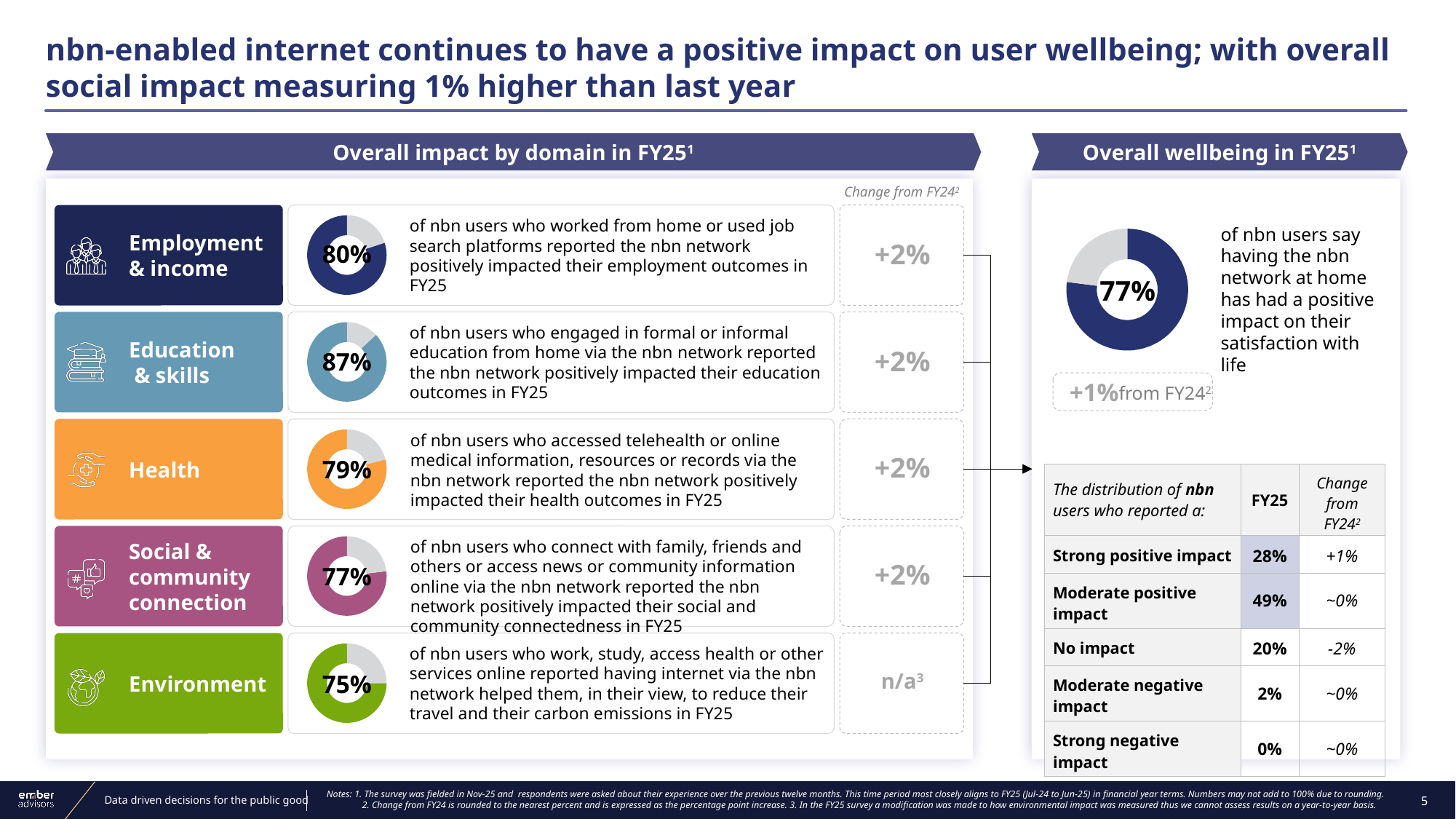
In the 'Overall wellbeing in FY25' panel, what percentage is shown in the donut chart? 77% Among the five domain donut charts in the 'Overall impact by domain in FY25' panel, which domain has the lowest percentage? Environment In the 'Overall impact by domain in FY25' panel, what percentage is shown in the Environment donut chart? 75% In the 'Overall impact by domain in FY25' panel, what percentage is shown in the Employment & income donut chart? 80% In the 'Overall impact by domain in FY25' panel, what change from FY24 is shown next to the Health donut chart? +2% In the 'Overall impact by domain in FY25' panel, which donut chart shows a larger value: Employment & income or Health? Employment & income In the 'Overall impact by domain in FY25' panel, what percentage is shown in the Education & skills donut chart? 87% What type of chart is used to show the Social & community connection value in the 'Overall impact by domain in FY25' panel? Donut (pie) chart In the 'Overall impact by domain in FY25' panel, what percentage is shown in the Health donut chart? 79% Among the five domain donut charts in the 'Overall impact by domain in FY25' panel, which domain has the highest percentage? Education & skills How many domain donut charts are shown in the 'Overall impact by domain in FY25' panel? 5 In the 'Overall impact by domain in FY25' panel, what is the difference in percentage points between the Education & skills donut chart and the Environment donut chart? 12